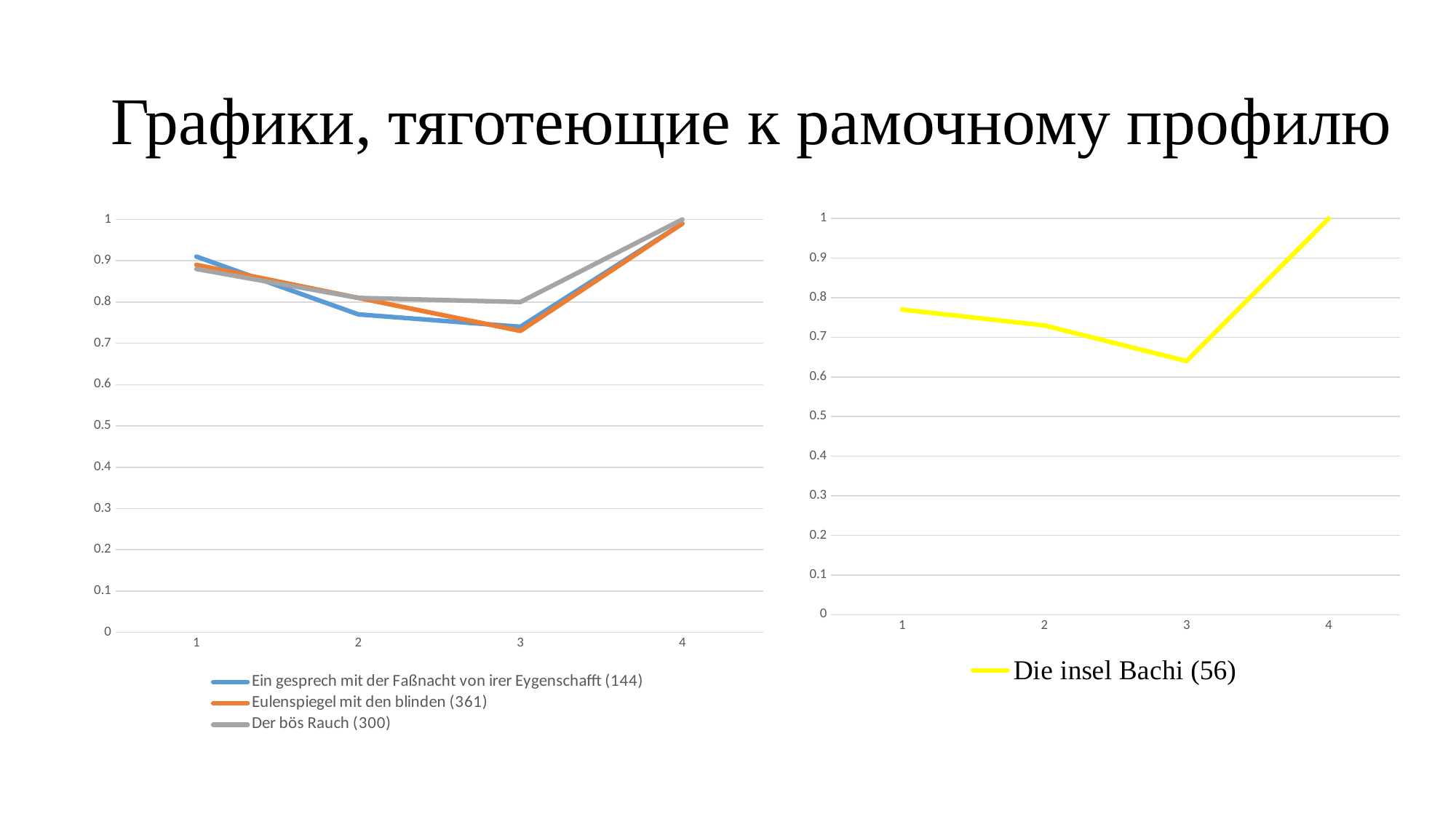
In the right chart, is the value at point 1 greater or less than 0.7? greater How many points are plotted along the x axis of the right chart? 4 How many series does the legend of the left chart list? 3 In the left chart, at point 3, which is larger: Der bös Rauch (300) or Eulenspiegel mit den blinden (361)? Der bös Rauch (300) In the right chart, what is the value of Die insel Bachi (56) at point 4? 1 In the left chart, which series has the lowest value at point 2? Ein gesprech mit der Faßnacht von irer Eygenschafft (144) How many series does the legend of the right chart list? 1 What kind of chart is the left chart? line chart In the right chart, is the value at point 3 greater or less than 0.7? less In the right chart, do the values rise or fall from point 1 to point 3? fall In the right chart, at which x-axis point is the value lowest? 3 In the right chart, at which x-axis point is the value highest? 4